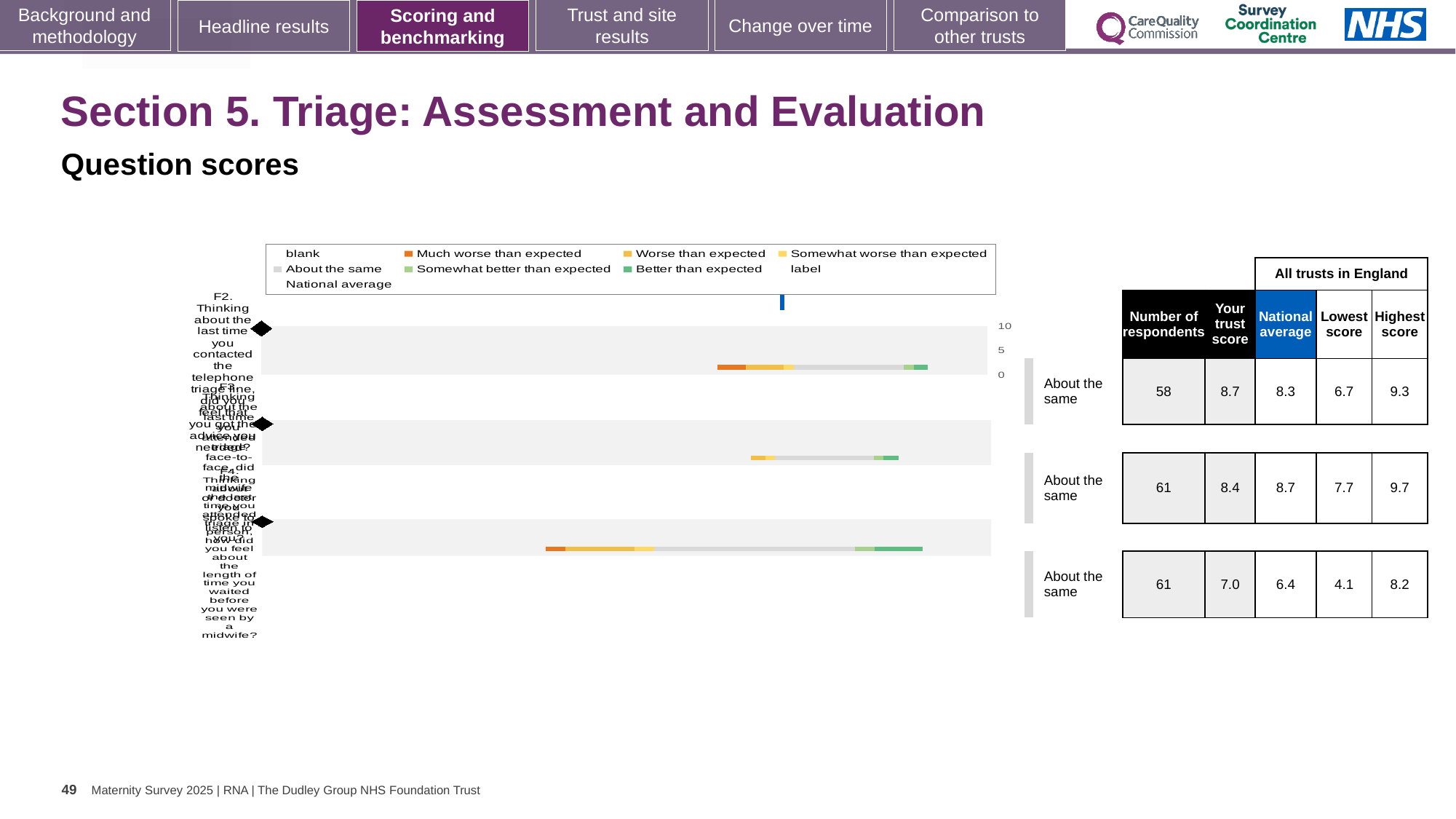
What kind of chart is shown on the slide? bar chart In the table next to the chart, what is the number of respondents for the first (top) question? 58 In the table next to the chart, what is the trust score for the second question? 8.4 Which question row has the lowest 'Lowest score' in the table? the third (bottom) question, 4.1 What benchmark label is shown beside each of the three question bars? About the same In the table next to the chart, what is the highest score across all trusts for the second question? 9.7 In the table next to the chart, what is the national average for the third (bottom) question? 6.4 For the second question, is the trust score greater or less than the national average? less Which question row has the highest 'Your trust score' in the table? the first (top) question, 8.7 For the third (bottom) question, what is the difference between the highest score and the lowest score in the table? 4.1 For the first (top) question, is the trust score or the national average larger? the trust score (8.7) How many question bars are plotted in the chart? 3